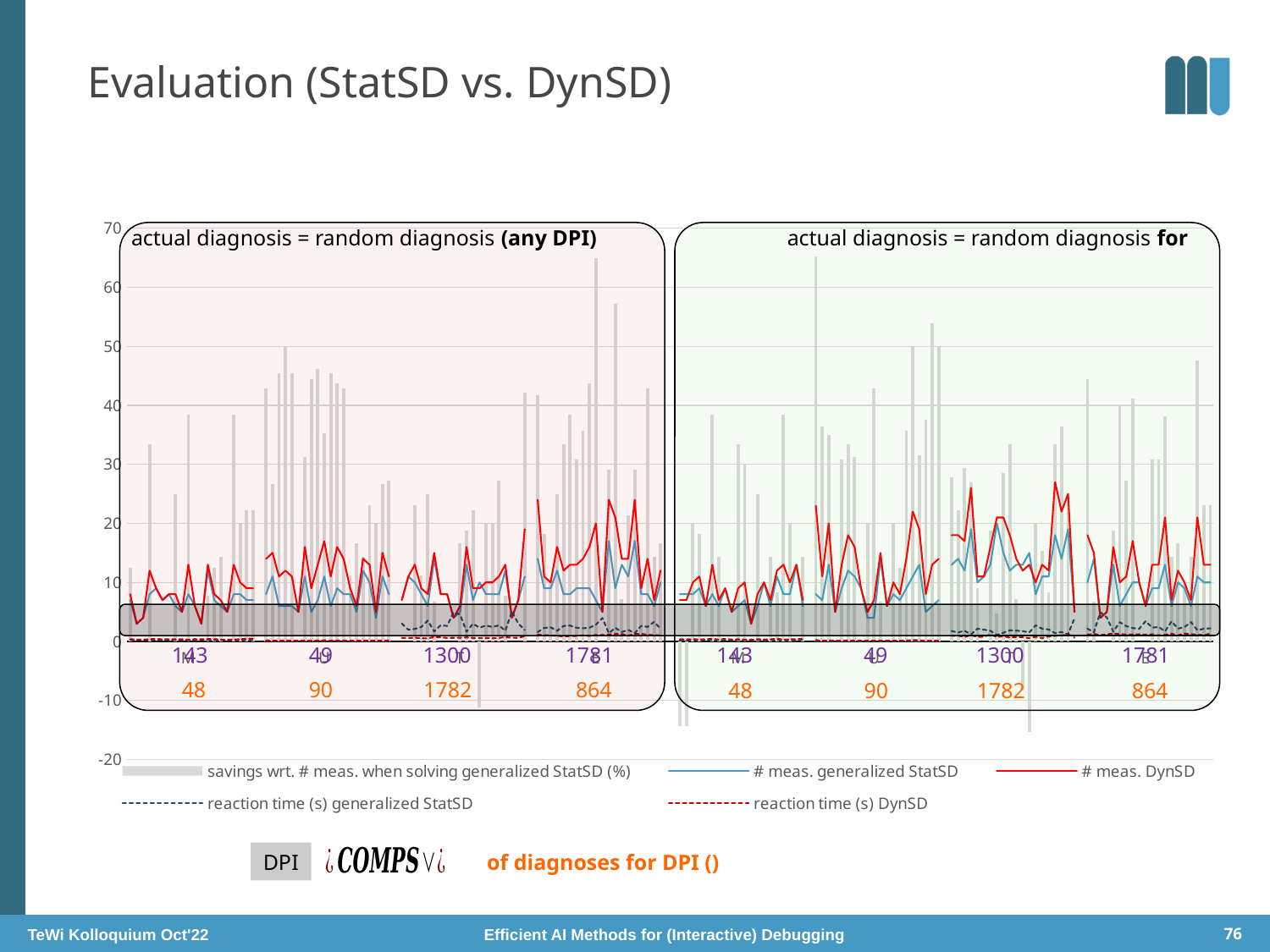
How many series does the chart legend list? 5 Which series is drawn as the solid red line? # meas. DynSD Which series is shown as the gray bars? savings wrt. # meas. when solving generalized StatSD (%) Are the values of the reaction time (s) DynSD series greater or less than 10? less What kind of chart is shown on the slide? Combination bar and line chart Are the values of the reaction time (s) generalized StatSD series greater or less than 10? less